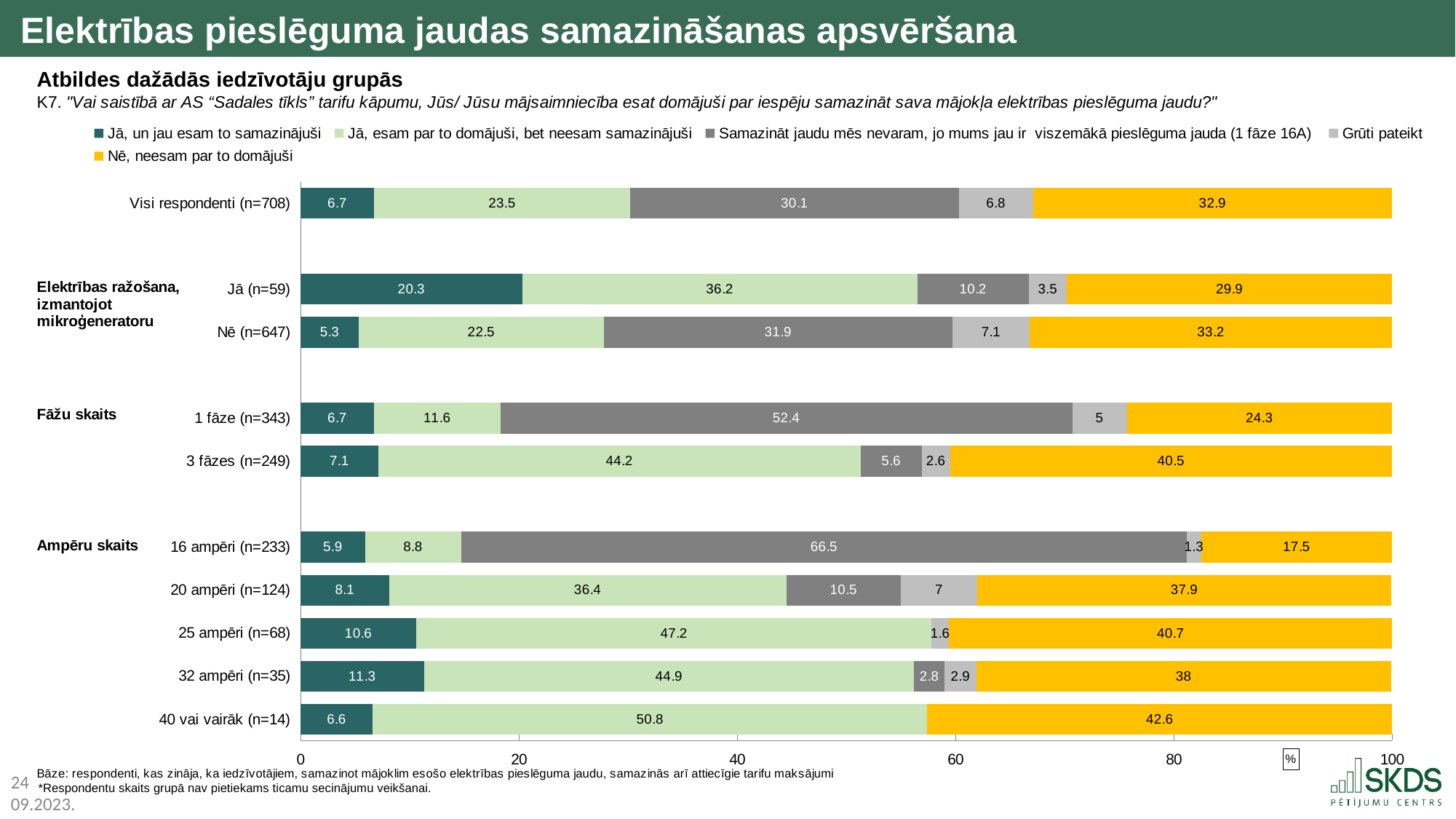
Which is larger: the "Jā, esam par to domājuši, bet neesam samazinājuši" value for 25 ampēri (n=68) or for 20 ampēri (n=124)? 25 ampēri (n=68) How many series does the legend list? 5 What is the value of "Samazināt jaudu mēs nevaram, jo mums jau ir viszemākā pieslēguma jauda (1 fāze 16A)" for 16 ampēri (n=233)? 66.5 What is the value of "Jā, un jau esam to samazinājuši" for Jā (n=59)? 20.3 What colour represents "Nē, neesam par to domājuši" in the chart? yellow What is the difference between the "Samazināt jaudu mēs nevaram..." values for 1 fāze (n=343) and 3 fāzes (n=249)? 46.8 What is the value of "Grūti pateikt" for 3 fāzes (n=249)? 2.6 What kind of chart is shown on the slide? stacked bar chart How many respondent groups (bars) are plotted in the chart? 10 Which group has the lowest value for "Nē, neesam par to domājuši"? 16 ampēri (n=233) What is the value of "Nē, neesam par to domājuši" for Visi respondenti (n=708)? 32.9 Which group has the highest value for "Jā, un jau esam to samazinājuši"? Jā (n=59)